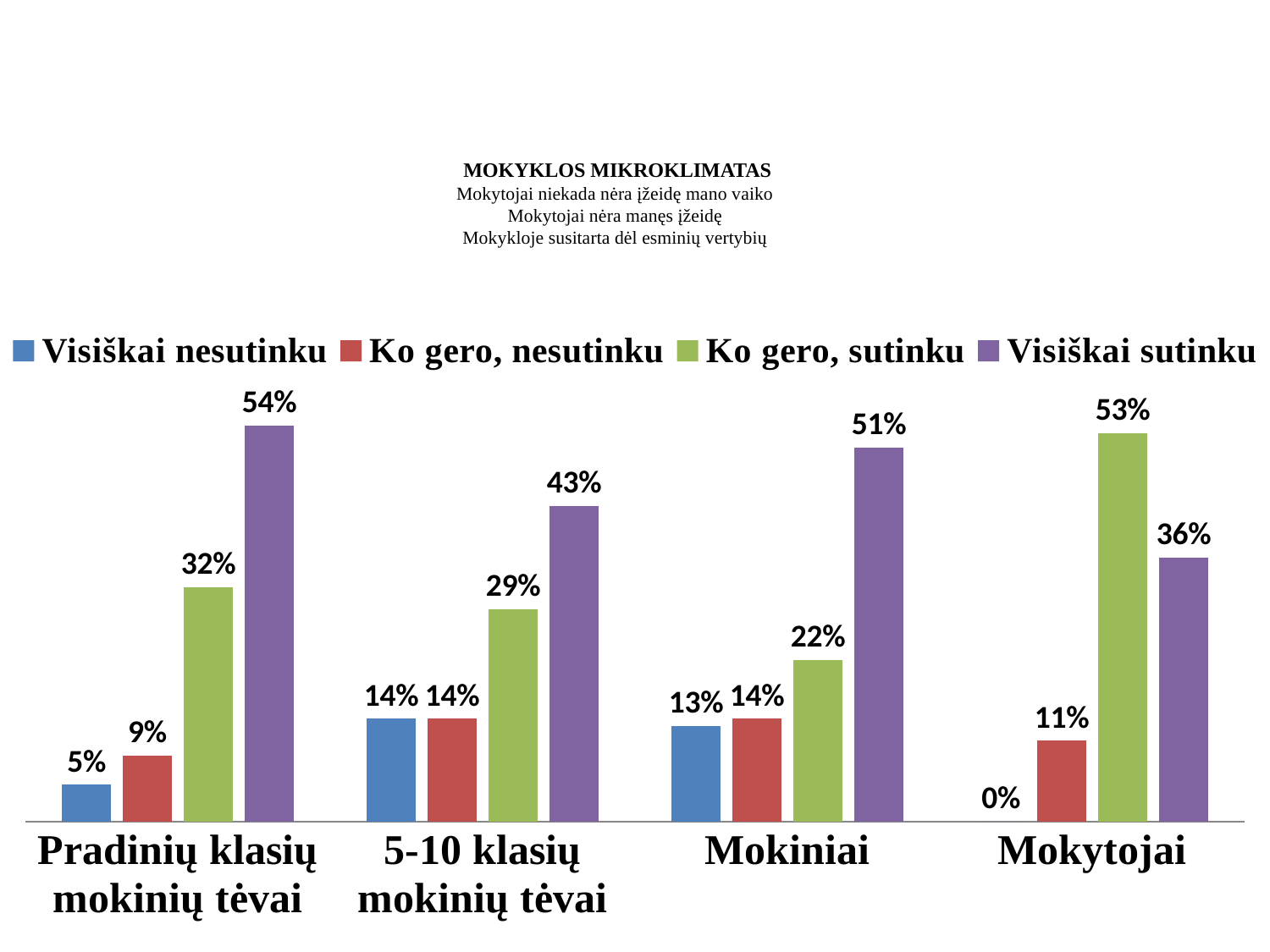
What is the value for "Visiškai sutinku" in the "Pradinių klasių mokinių tėvai" category? 54% What kind of chart is shown on the slide? Bar chart What is the difference between "Visiškai sutinku" and "Ko gero, sutinku" in the "5-10 klasių mokinių tėvai" category? 14% What colour represents the "Ko gero, nesutinku" series? Red How many series does the legend list? 4 What is the value for "Ko gero, sutinku" in the "Mokytojai" category? 53% What is the value for "Visiškai nesutinku" in the "Mokytojai" category? 0% Which category has the highest value for "Visiškai sutinku"? Pradinių klasių mokinių tėvai What is the value for "Ko gero, nesutinku" in the "Mokiniai" category? 14% Which is larger in the "Mokytojai" category: "Ko gero, sutinku" or "Visiškai sutinku"? Ko gero, sutinku Which category has the lowest value for "Ko gero, sutinku"? Mokiniai How many categories are shown on the x axis? 4